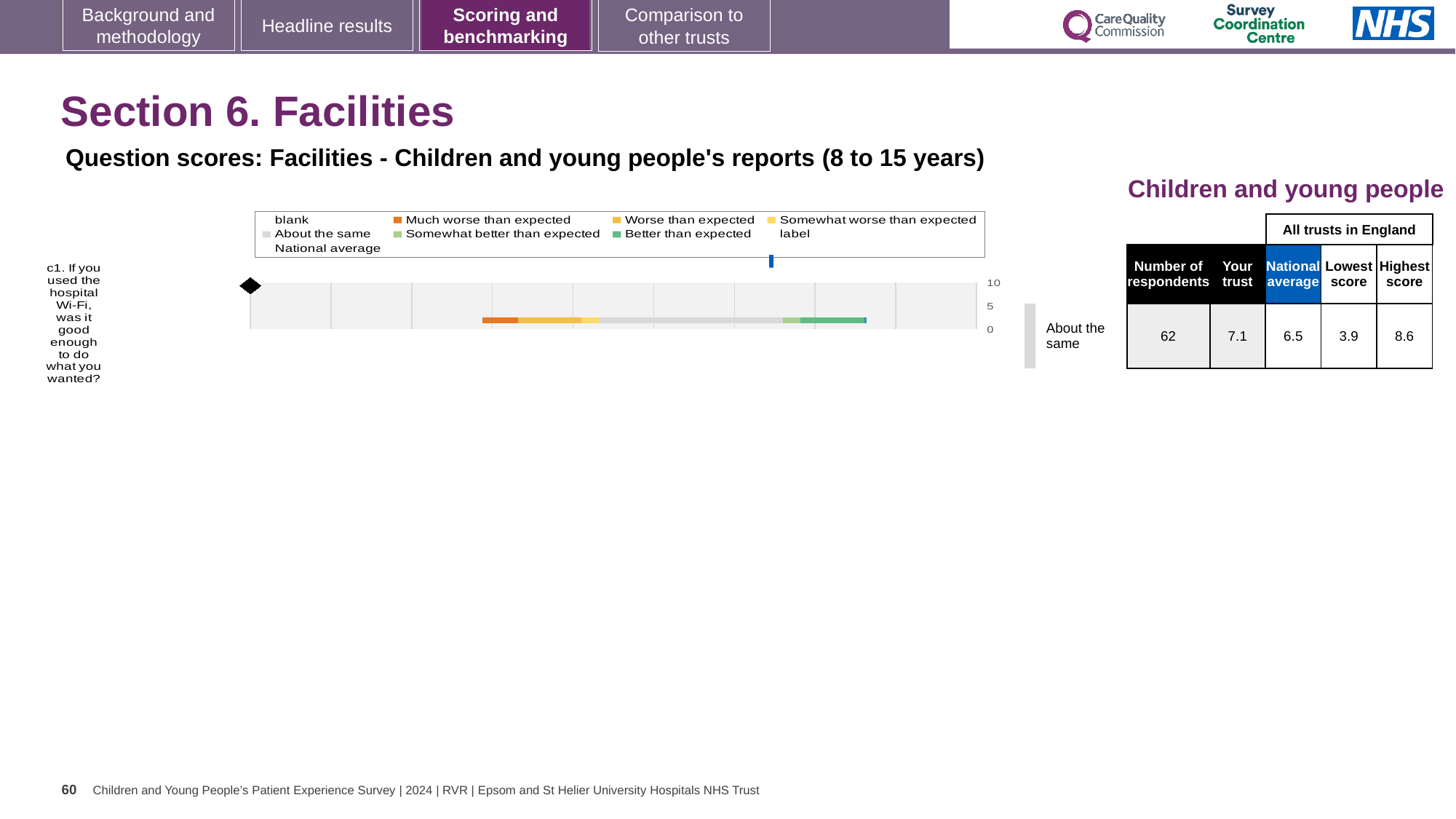
What kind of chart is used to show the question score for c1 on this slide? bar chart Which legend entry is shown in orange? Much worse than expected What is the highest score among all trusts in England for question c1? 8.6 What is the national average score for question c1 about the hospital Wi-Fi? 6.5 What is the lowest score among all trusts in England for question c1? 3.9 How many entries does the chart legend list? 9 Which is larger for question c1: the trust's score or the national average? the trust's score What is the trust's score for question c1 about the hospital Wi-Fi? 7.1 What is the difference between the highest and lowest scores for question c1? 4.7 What benchmark category is shown for question c1 (hospital Wi-Fi)? About the same How many survey questions are plotted in the chart? 1 How many respondents answered question c1 about the hospital Wi-Fi? 62